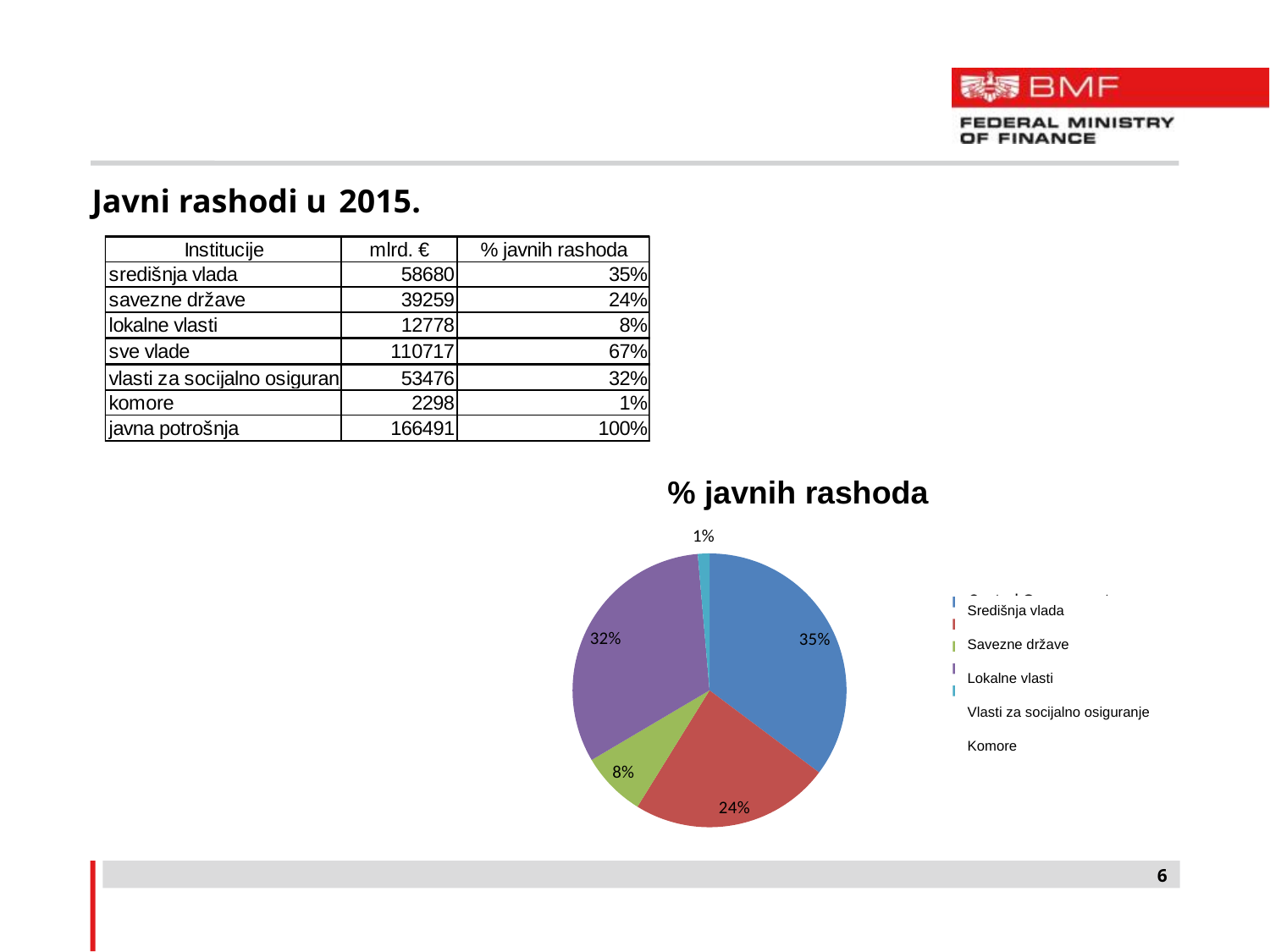
What share of the pie does Komore have? 1% What kind of chart is shown on the slide? pie chart Which slice is larger, Vlasti za socijalno osiguranje or Lokalne vlasti? Vlasti za socijalno osiguranje How many slices does the pie chart have? 5 What is the title of the chart? % javnih rashoda What share of the pie does Savezne države have? 24% What share of the pie does Vlasti za socijalno osiguranje have? 32% What is the difference in percentage points between the Središnja vlada slice and the Savezne države slice? 11% Which category has the smallest slice of the pie? Komore Which category has the largest slice of the pie? Središnja vlada